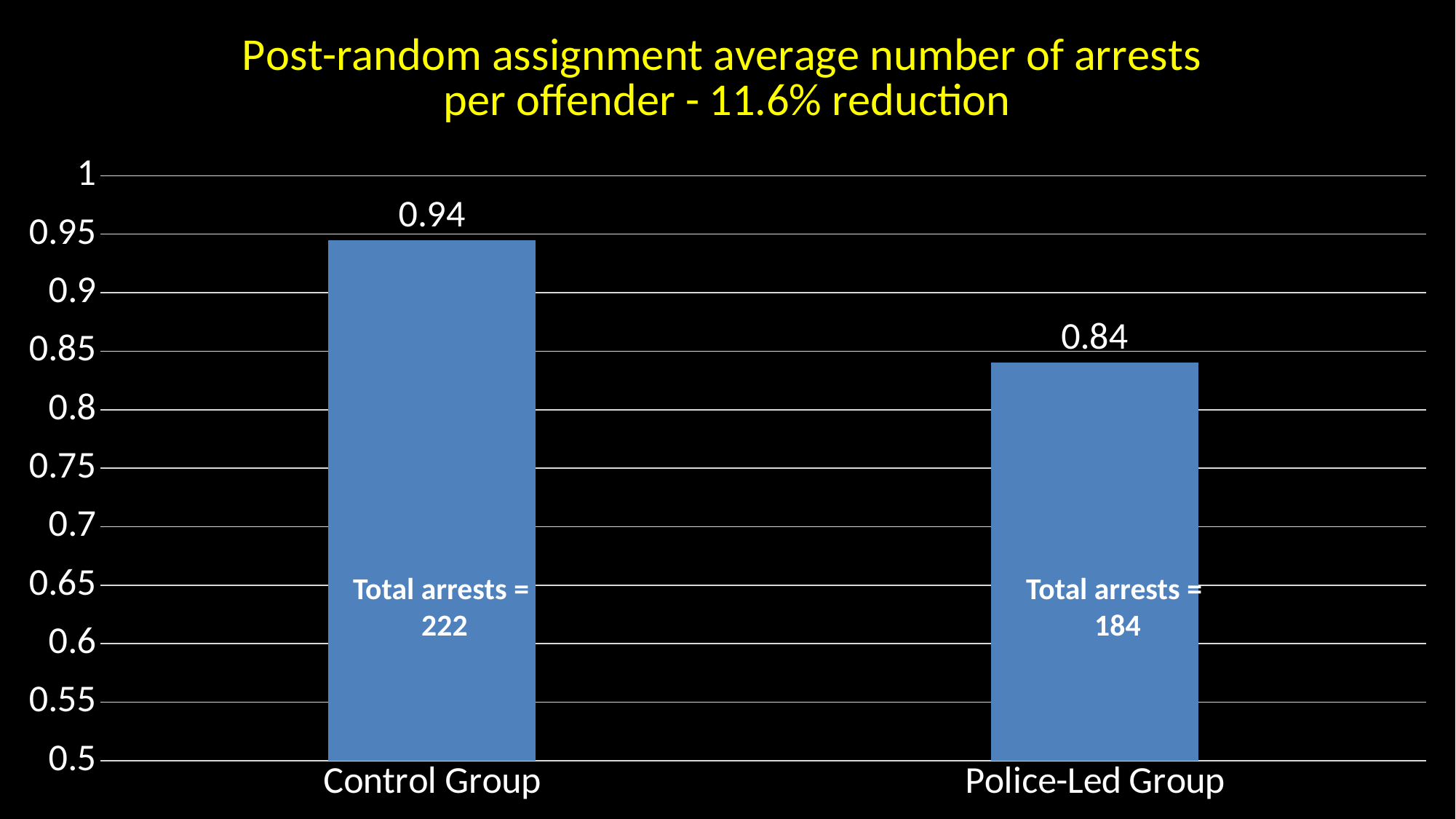
Is the value for the Police-Led Group greater or less than 0.9? less What is the difference between the Control Group and Police-Led Group average arrests per offender? 0.1 What is the average number of arrests per offender for the Control Group? 0.94 What is the average number of arrests per offender for the Police-Led Group? 0.84 How many groups are shown on the chart? 2 Which group has the lower average number of arrests per offender? Police-Led Group What is the total number of arrests shown for the Police-Led Group bar? 184 Is the value for the Control Group greater or less than 0.9? greater What kind of chart is shown on the slide? Bar chart Which group has the higher average number of arrests per offender? Control Group What is the total number of arrests shown for the Control Group bar? 222 What percentage reduction is stated in the chart title? 11.6%